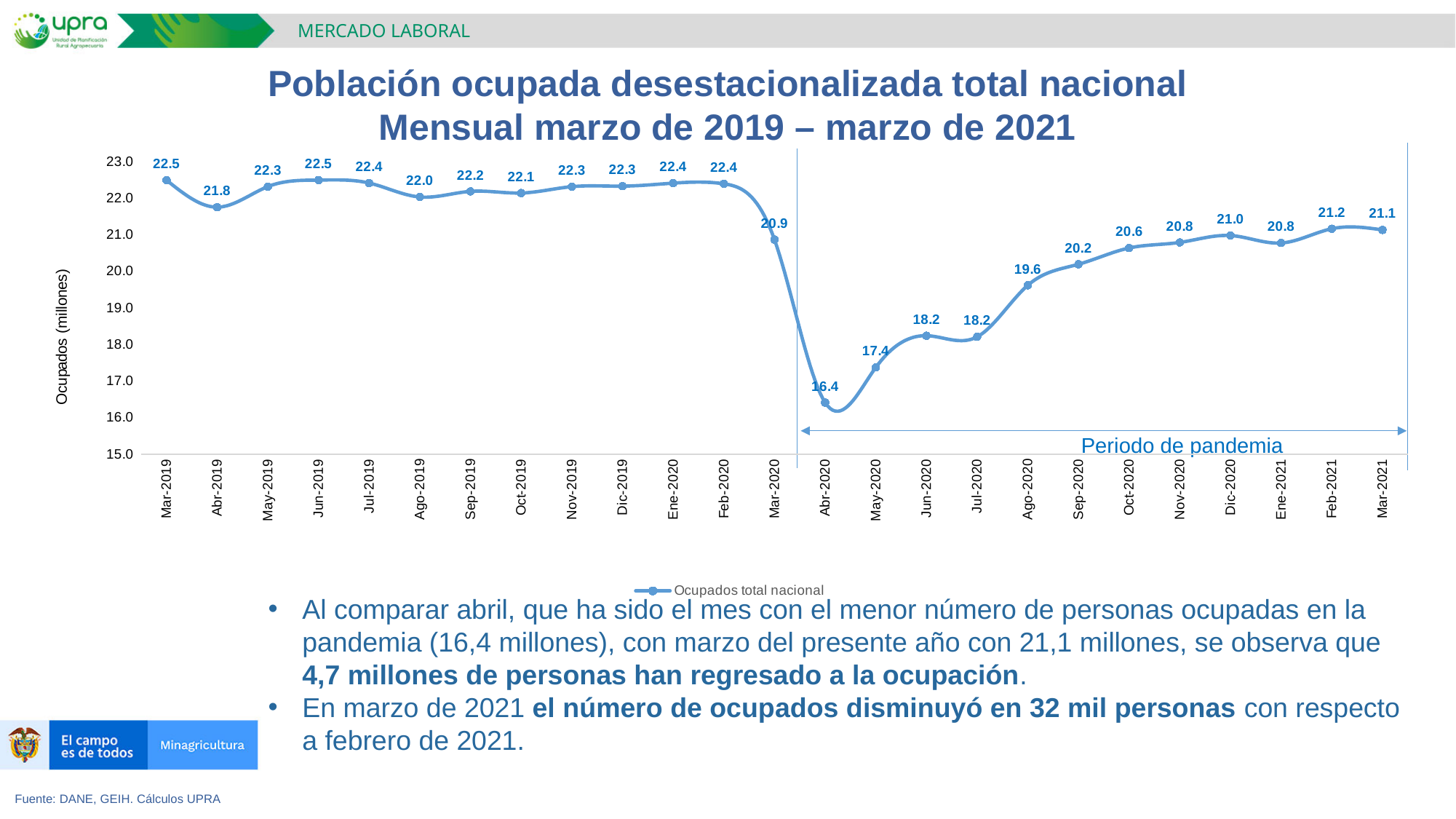
What is the value for Mar-2021? 21.1 What is the value for Abr-2020? 16.4 What is the value for Feb-2020? 22.4 Is the value for Abr-2020 greater or less than 17.0? less Which month has the lowest value? Abr-2020 What is the difference between the values for Mar-2021 and Abr-2020? 4.7 How many series does the legend list? 1 Which is larger, the value for Dic-2020 or the value for Ene-2021? Dic-2020 What kind of chart is shown on the slide? line chart What is the difference between the values for Feb-2020 and Mar-2020? 1.5 How many monthly data points are plotted on the chart? 25 What is the value for Ago-2020? 19.6